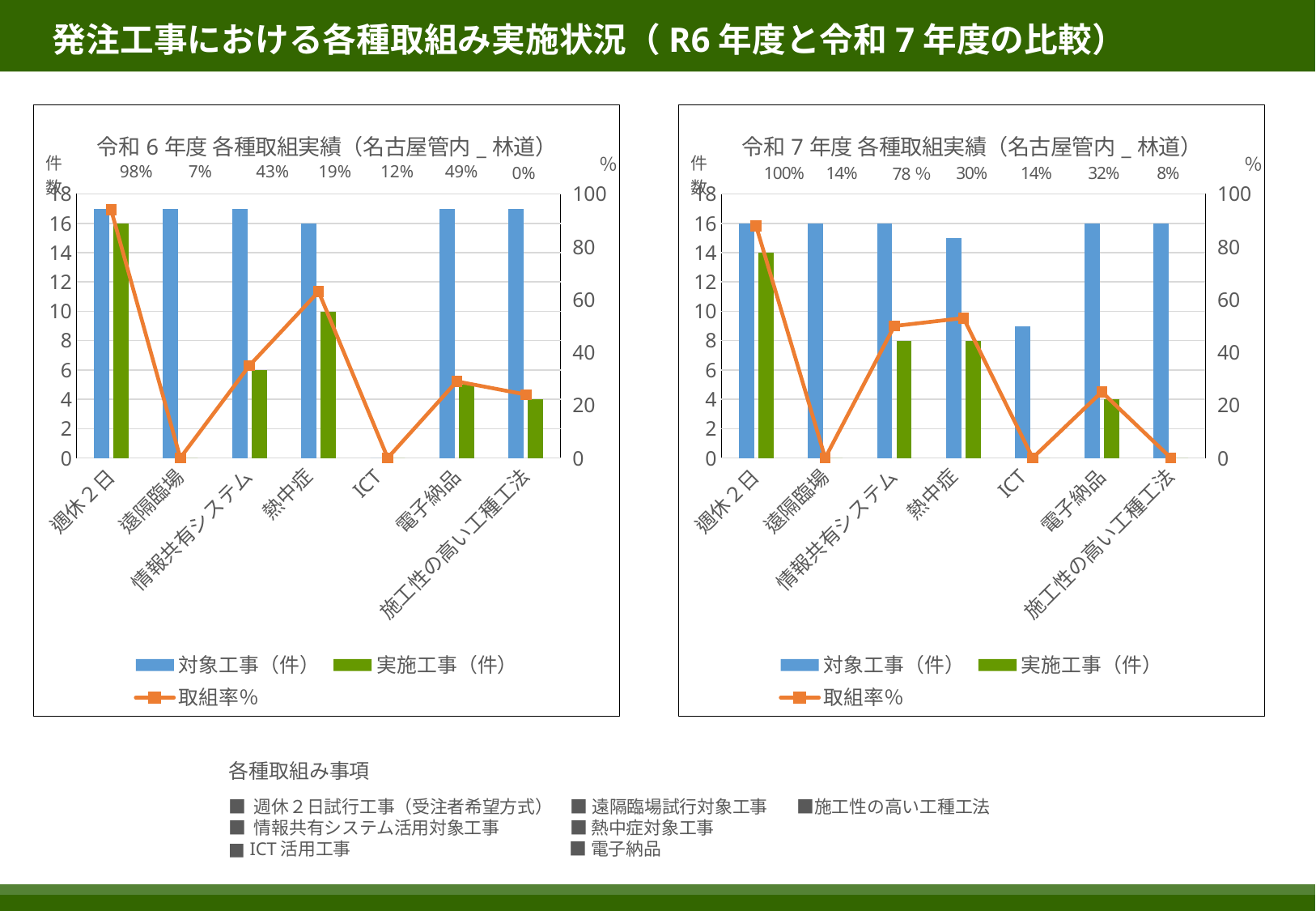
In the right chart (令和7年度), is the 対象工事（件） value for ICT greater or less than 10? less In the left chart (令和6年度), which category has the lowest 取組率%? 遠隔臨場 and ICT (both 0%) What kind of chart is the right chart (令和7年度)? Combination bar and line chart How many series does the legend of the left chart (令和6年度) list? 3 In the left chart (令和6年度), what is the difference in 取組率% between 電子納品 and 情報共有システム? 6 percentage points What is the title of the left chart? 令和6年度 各種取組実績（名古屋管内_林道） In the right chart (令和7年度), what is the 実施工事（件） value for 週休2日? 14 In the left chart (令和6年度), which has a higher 取組率%, 熱中症 or ICT? 熱中症 In the right chart (令和7年度), which category has the highest 取組率%? 週休2日 How many categories are shown on the x axis of the right chart (令和7年度)? 7